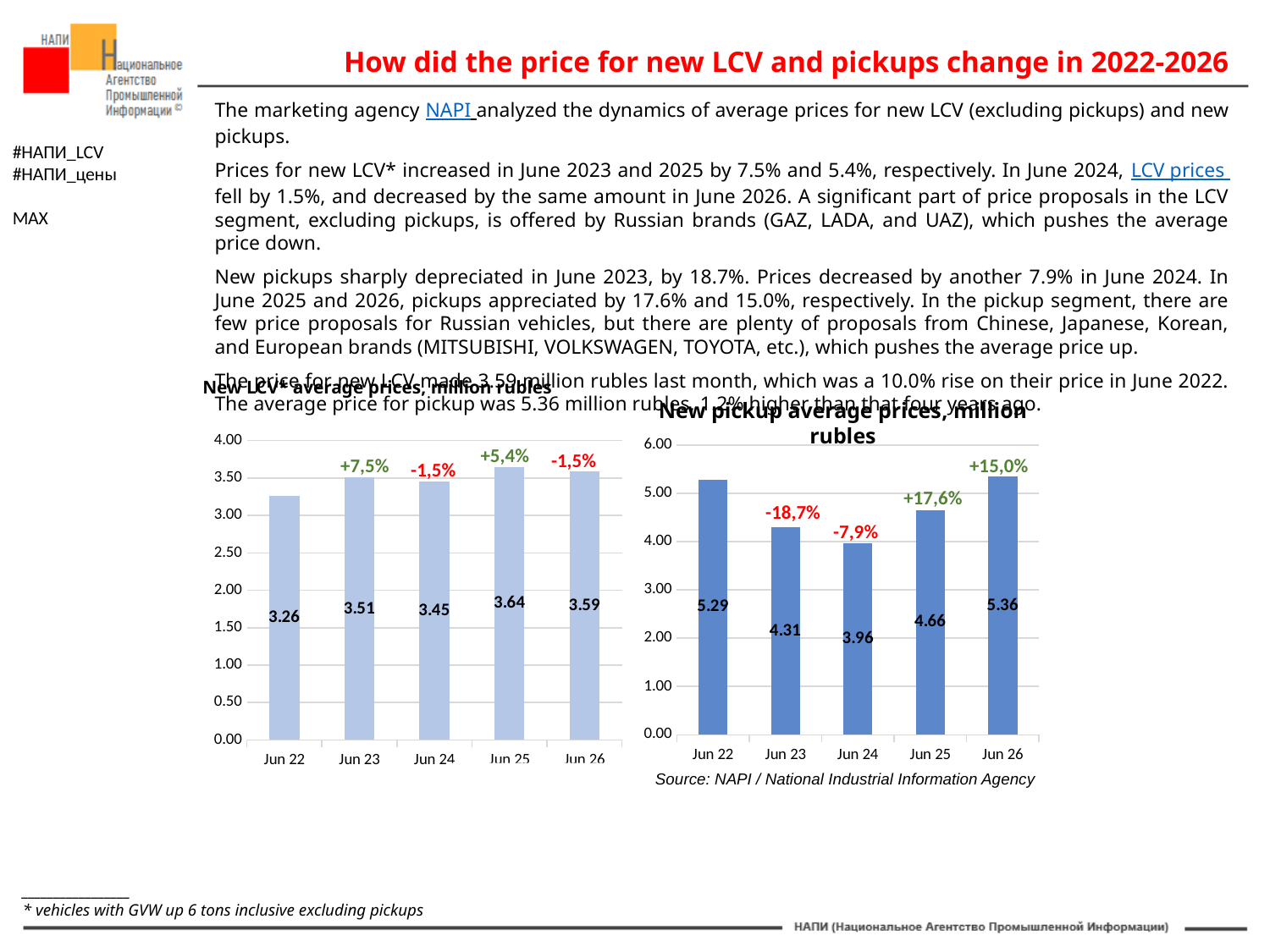
In the 'New pickup average prices, million rubles' chart, which period has the highest value? Jun 26 In the 'New LCV* average prices, million rubles' chart, what is the value for Jun 22? 3.26 In the 'New pickup average prices, million rubles' chart, which period has the lowest value? Jun 24 In the 'New pickup average prices, million rubles' chart, what is the difference between the values for Jun 22 and Jun 23? 0.98 In the 'New pickup average prices, million rubles' chart, is the value for Jun 25 greater or less than 4.00? greater What kind of chart is the 'New LCV* average prices, million rubles' chart? bar chart How many bars are plotted in the 'New pickup average prices, million rubles' chart? 5 In the 'New pickup average prices, million rubles' chart, what percentage change label is shown above the Jun 23 bar? -18,7% In the 'New LCV* average prices, million rubles' chart, which is larger, the value for Jun 23 or Jun 24? Jun 23 In the 'New pickup average prices, million rubles' chart, what is the value for Jun 24? 3.96 In the 'New LCV* average prices, million rubles' chart, what is the difference between the values for Jun 25 and Jun 22? 0.38 In the 'New LCV* average prices, million rubles' chart, which period has the highest value? Jun 25